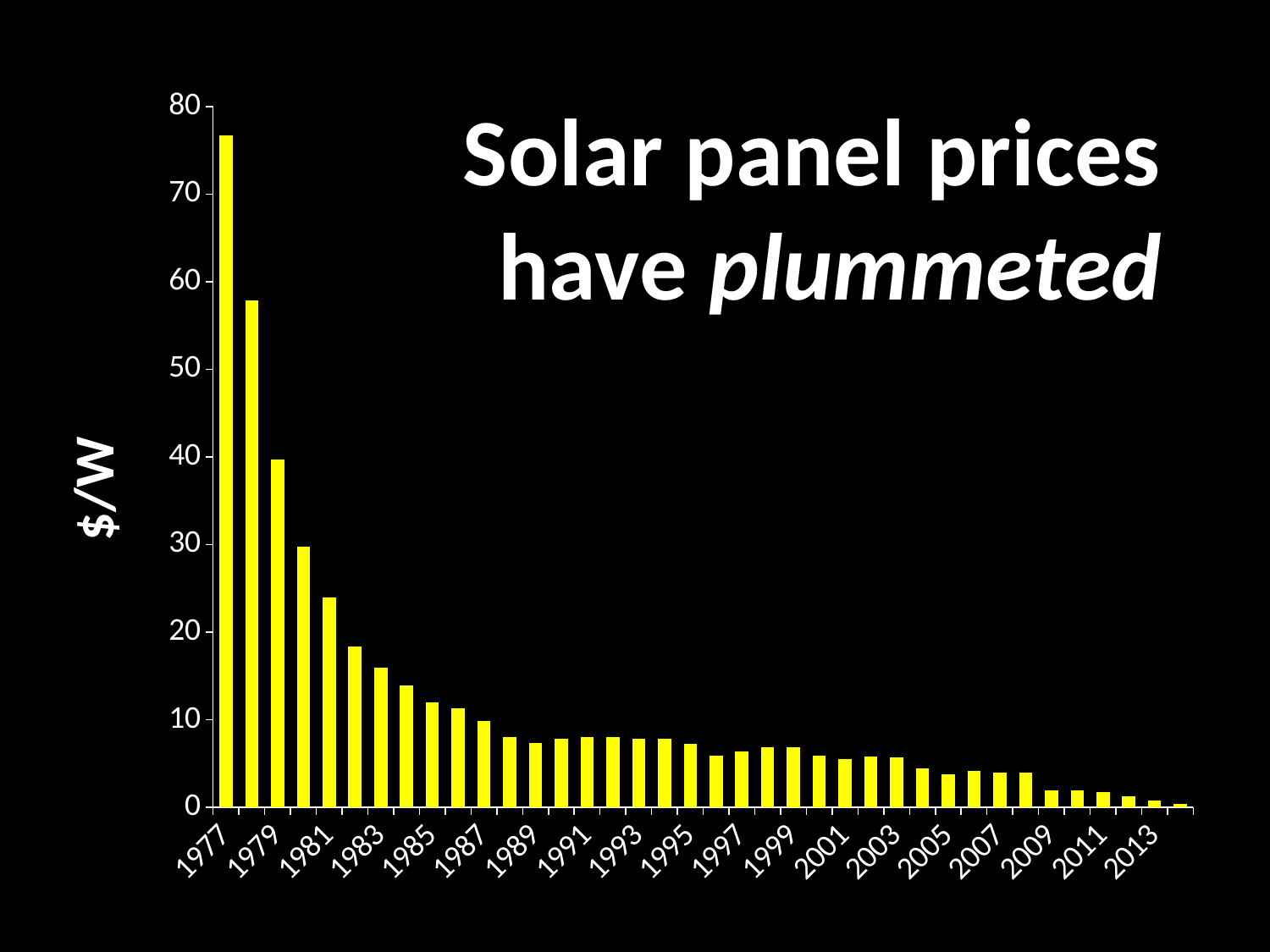
Do solar panel prices rise or fall from 1977 to 2013 along the x axis? fall What kind of chart is shown on the slide? bar chart Is the value for 1985 greater or less than 10? greater What colour are the bars in the chart? yellow Which year has the larger value, 1977 or 1979? 1977 Which year has the larger value, 1983 or 2003? 1983 Is the value for 1977 greater or less than 70? greater What is the label on the vertical axis of the chart? $/W Which year has the highest solar panel price in the chart? 1977 Is the value for 2009 greater or less than 10? less